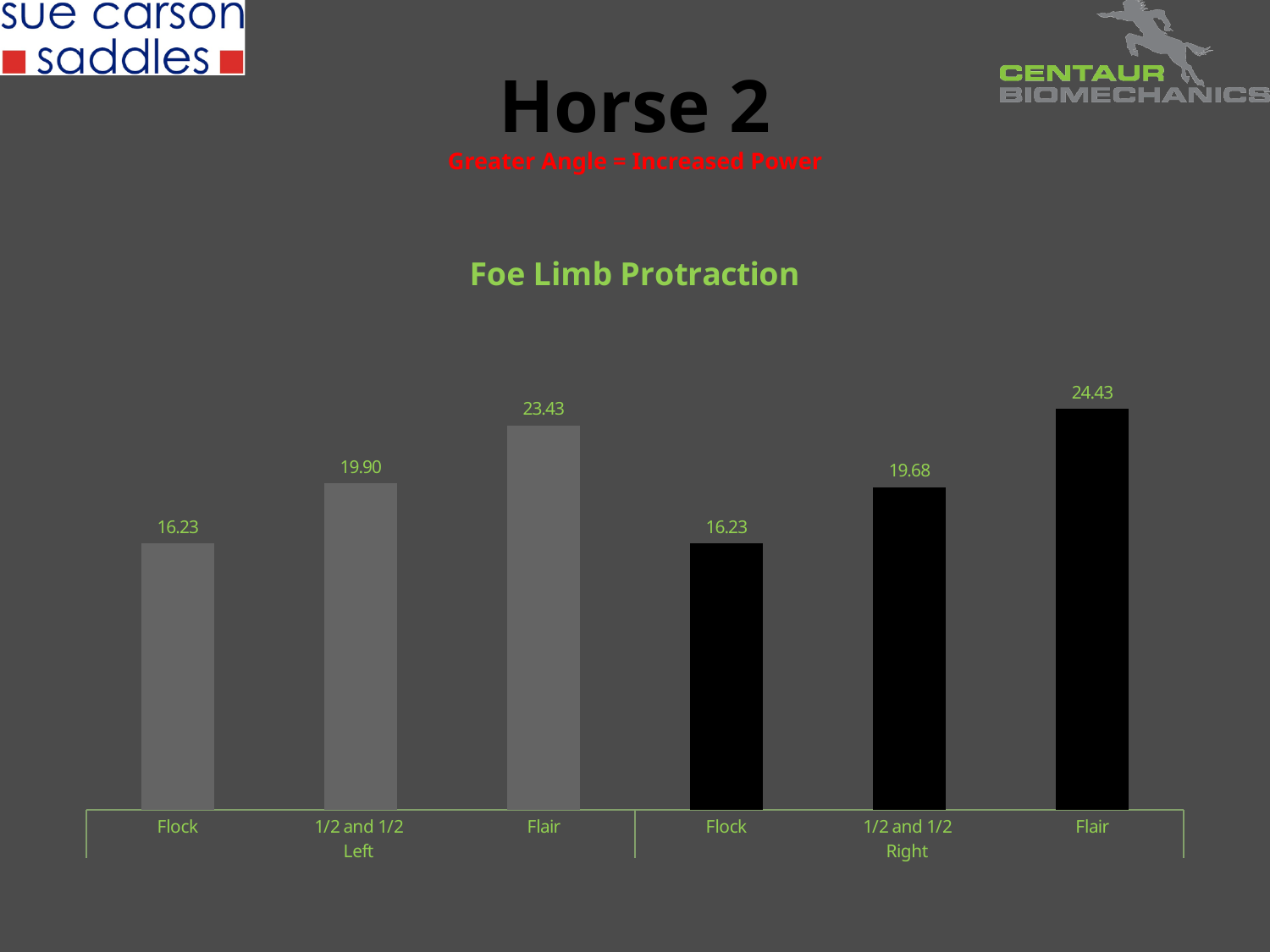
Within the Right group, which category has the lowest value? Flock What is the title of the chart? Foe Limb Protraction Which is larger: 1/2 and 1/2 in the Left group or 1/2 and 1/2 in the Right group? 1/2 and 1/2 in the Left group How many bars are plotted on the chart? 6 What is the difference between Flair in the Right group and Flair in the Left group? 1.00 What kind of chart is shown? Bar chart What is the value for 1/2 and 1/2 in the Right group? 19.68 What is the value for Flair in the Left group? 23.43 What is the difference between Flair and Flock in the Right group? 8.20 What is the value for 1/2 and 1/2 in the Left group? 19.90 Which bar has the highest value on the chart? Flair (Right) What is the value for Flock in the Left group? 16.23